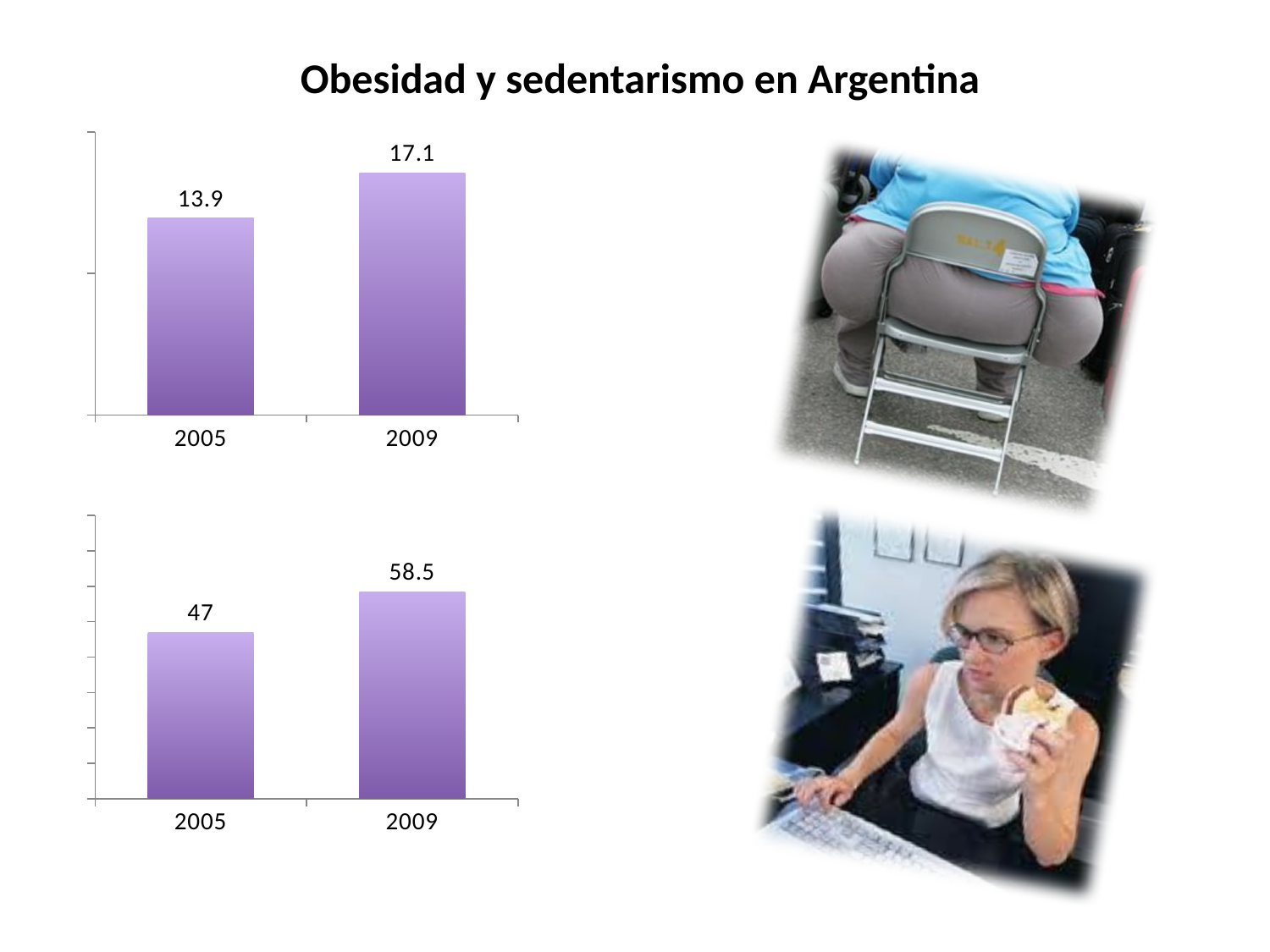
How many bars does the top chart have? 2 In the top chart, what is the difference between the 2009 and 2005 values? 3.2 In the top chart, do the values rise or fall from 2005 to 2009? rise In the bottom chart, what is the value for 2005? 47 In the bottom chart, what is the value for 2009? 58.5 In the top chart, what is the value for 2005? 13.9 In the bottom chart, what is the difference between the 2009 and 2005 values? 11.5 In the top chart, which year has the higher value? 2009 What type of chart is the bottom chart? bar chart In the top chart, what is the value for 2009? 17.1 In the bottom chart, is the value for 2005 larger or smaller than the value for 2009? smaller In the bottom chart, which year has the lower value? 2005